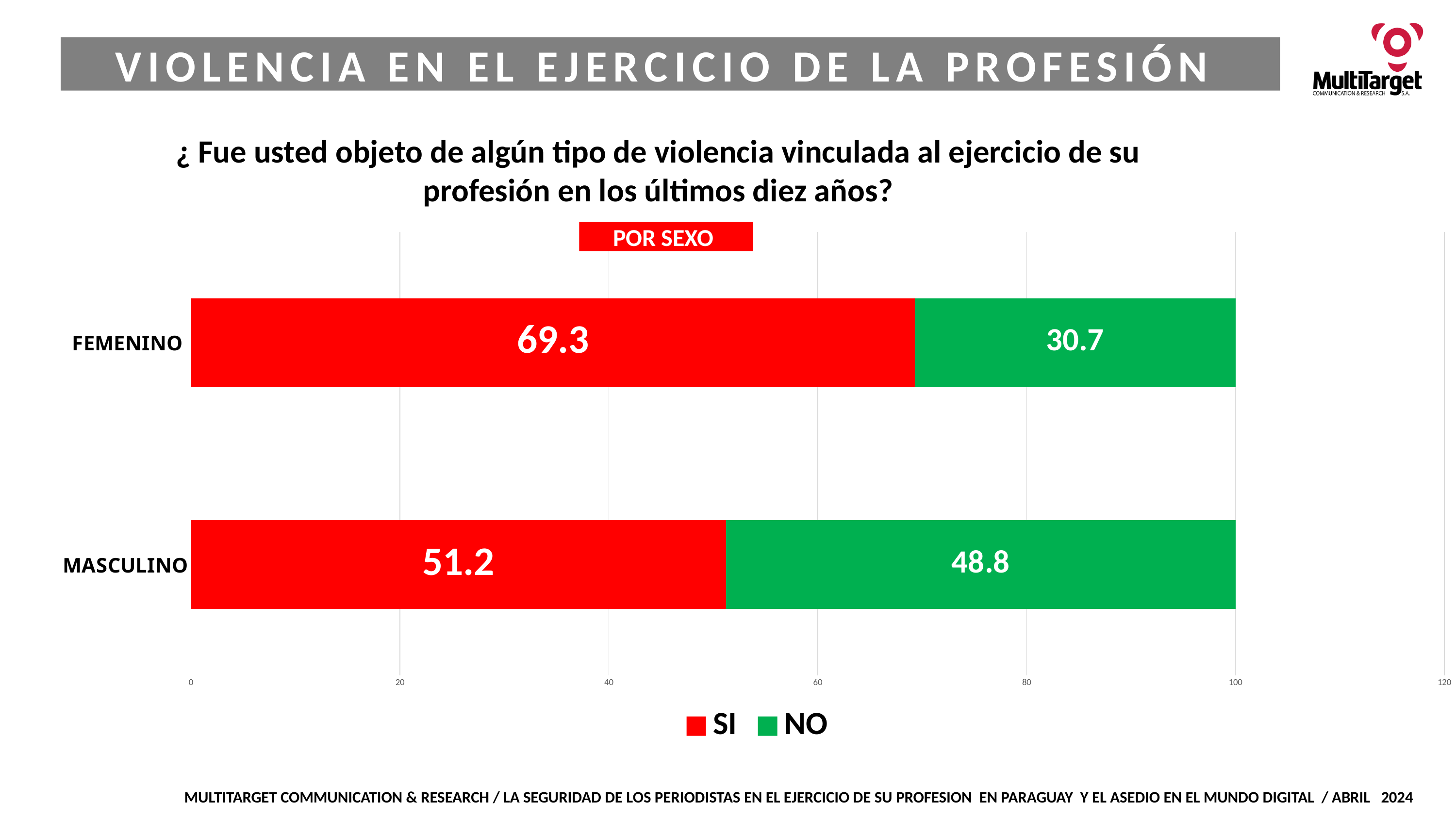
Which category has the lowest NO value? FEMENINO What is the difference between the SI values for FEMENINO and MASCULINO? 18.1 How many series does the legend list? 2 What is the NO value for MASCULINO? 48.8 What is the SI value for FEMENINO? 69.3 What is the NO value for FEMENINO? 30.7 Which category has the highest SI value? FEMENINO What is the total of the stacked bar for FEMENINO? 100 What is the SI value for MASCULINO? 51.2 Which is larger: the SI value for MASCULINO or the NO value for MASCULINO? SI What kind of chart is shown on the slide? Stacked bar chart How many categories are shown on the chart? 2